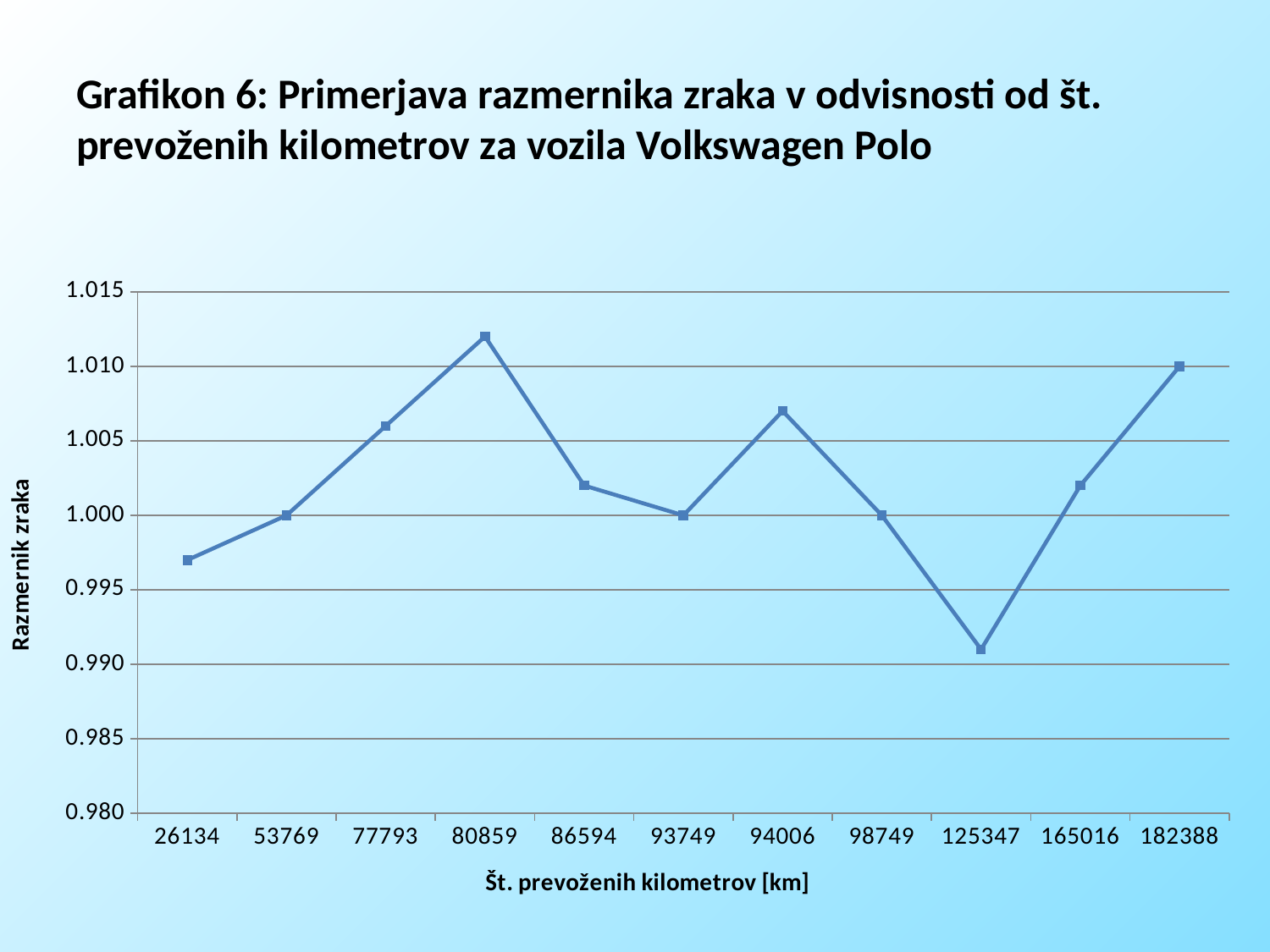
Is the value for 80859 km greater or less than 1.010? greater How many data points are plotted on the chart? 11 Is the value for 26134 km greater or less than 1.000? less Which has the larger air ratio: 26134 km or 125347 km? 26134 What is the air ratio value at 53769 km? 1.000 What kind of chart is shown on the slide? line chart What is the label of the x axis? Št. prevoženih kilometrov [km] At which number of kilometres is the air ratio (razmernik zraka) highest? 80859 What is the air ratio value at 182388 km? 1.010 At which number of kilometres is the air ratio (razmernik zraka) lowest? 125347 Does the air ratio rise or fall between 125347 km and 182388 km? rise Is the value for 125347 km greater or less than 0.995? less